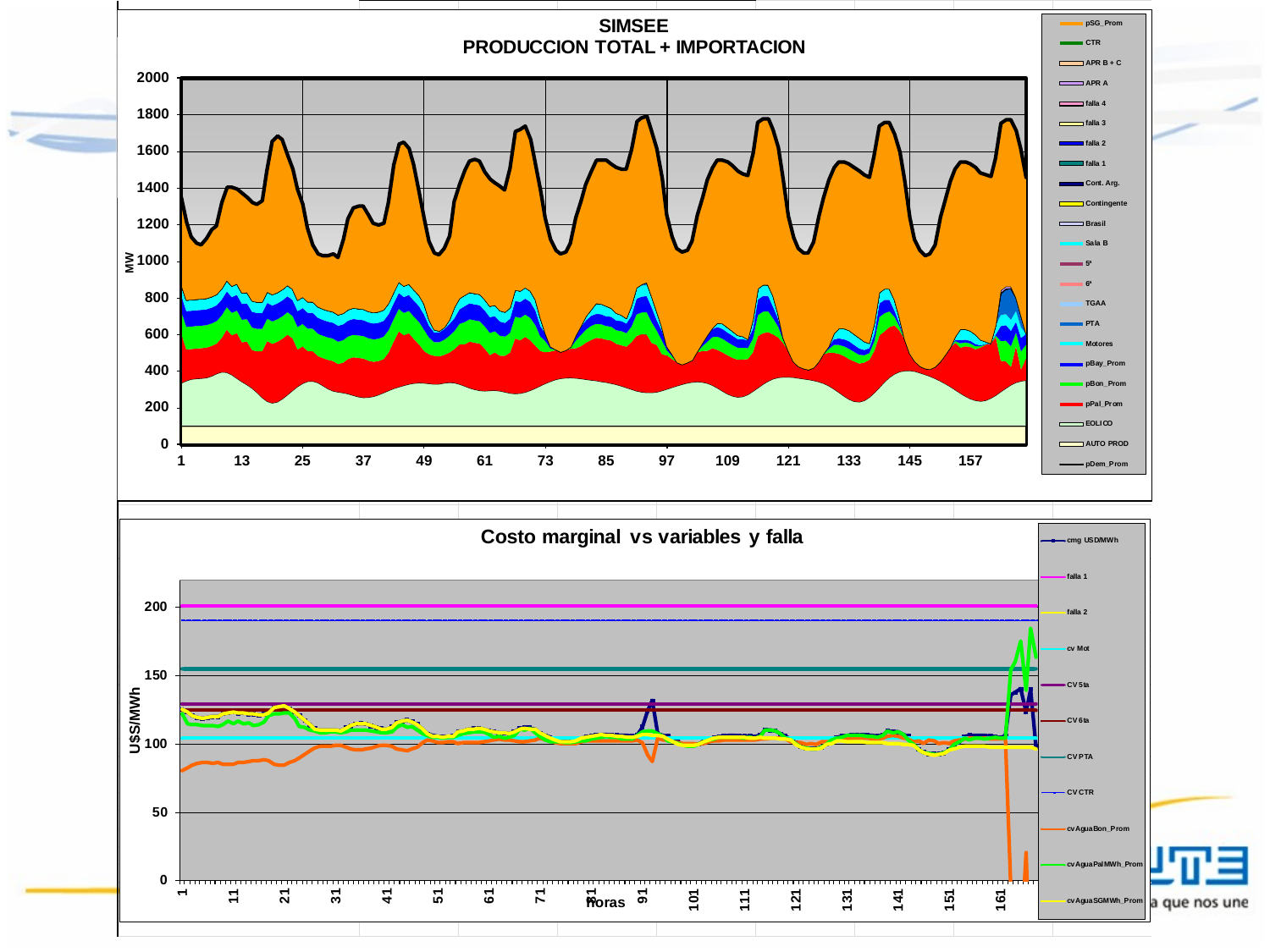
In the top chart 'SIMSEE PRODUCCION TOTAL + IMPORTACION', is the lowest point of the pDem_Prom line greater or less than 1200? less What kind of chart is the top chart titled 'SIMSEE PRODUCCION TOTAL + IMPORTACION'? stacked area chart In the top chart 'SIMSEE PRODUCCION TOTAL + IMPORTACION', is the highest peak of the pDem_Prom line greater or less than 1600? greater In the bottom chart 'Costo marginal vs variables y falla', is the value of the 'CV 5ta' line greater or less than 150? less How many series does the legend of the top chart 'SIMSEE PRODUCCION TOTAL + IMPORTACION' list? 23 What is the y-axis label of the top chart 'SIMSEE PRODUCCION TOTAL + IMPORTACION'? MW What kind of chart is the bottom chart titled 'Costo marginal vs variables y falla'? line chart What is the y-axis label of the bottom chart 'Costo marginal vs variables y falla'? U$S/MWh How many series does the legend of the bottom chart 'Costo marginal vs variables y falla' list? 11 In the bottom chart 'Costo marginal vs variables y falla', which line is higher: 'falla 1' or 'CV 6ta'? falla 1